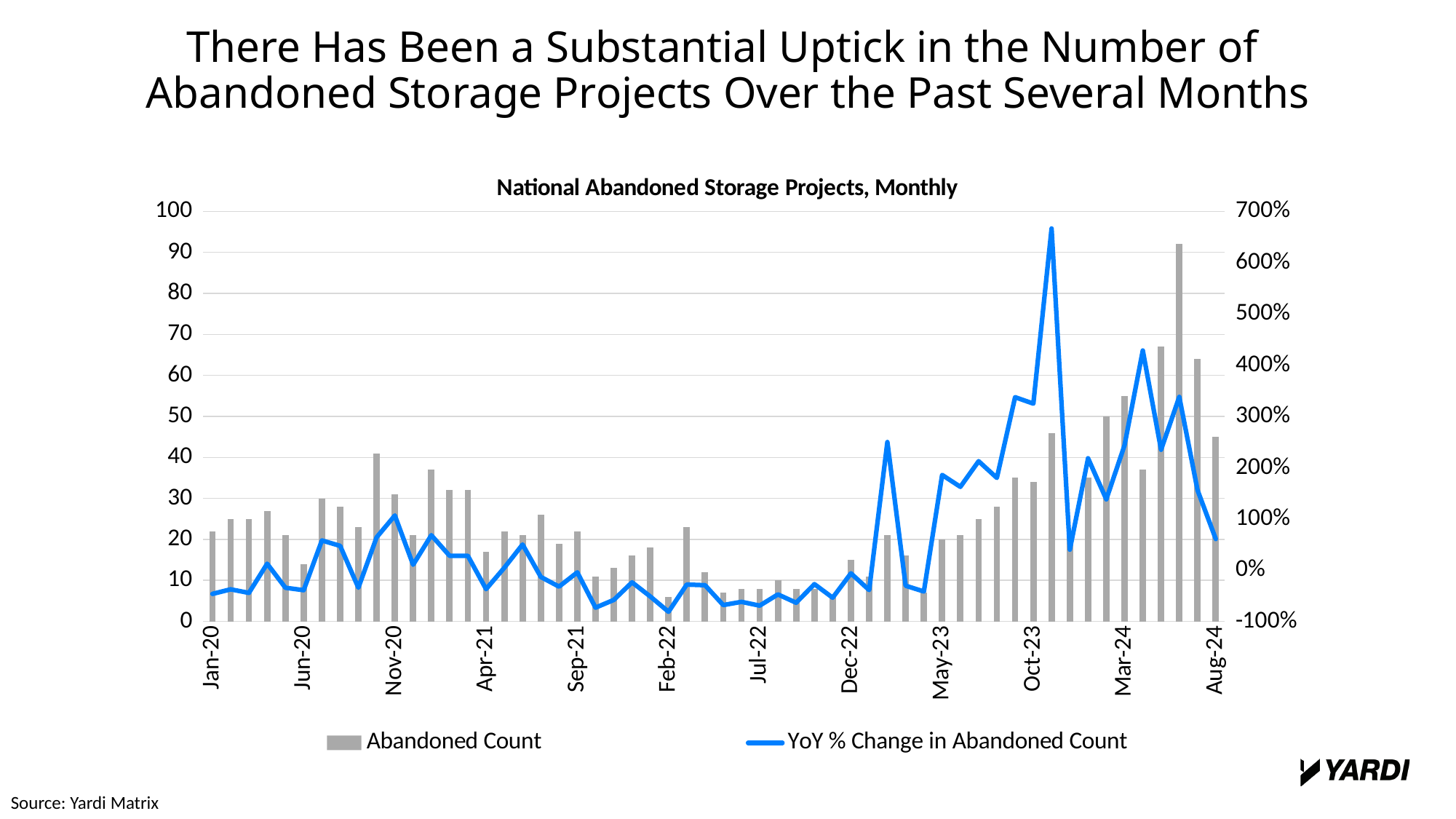
Which month has the larger Abandoned Count, Mar-24 or Jan-20? Mar-24 Is the Abandoned Count for Mar-24 greater or less than 50? greater What is the title of the chart? National Abandoned Storage Projects, Monthly How many series does the legend list? 2 Is the YoY % Change in Abandoned Count for Jan-20 greater or less than 0%? less Which series is plotted as a blue line? YoY % Change in Abandoned Count Is the Abandoned Count for Feb-22 greater or less than 10? less What kind of chart is shown on the slide? A combined bar and line chart Do the Abandoned Count bars generally rise or fall from Dec-22 to Mar-24? rise